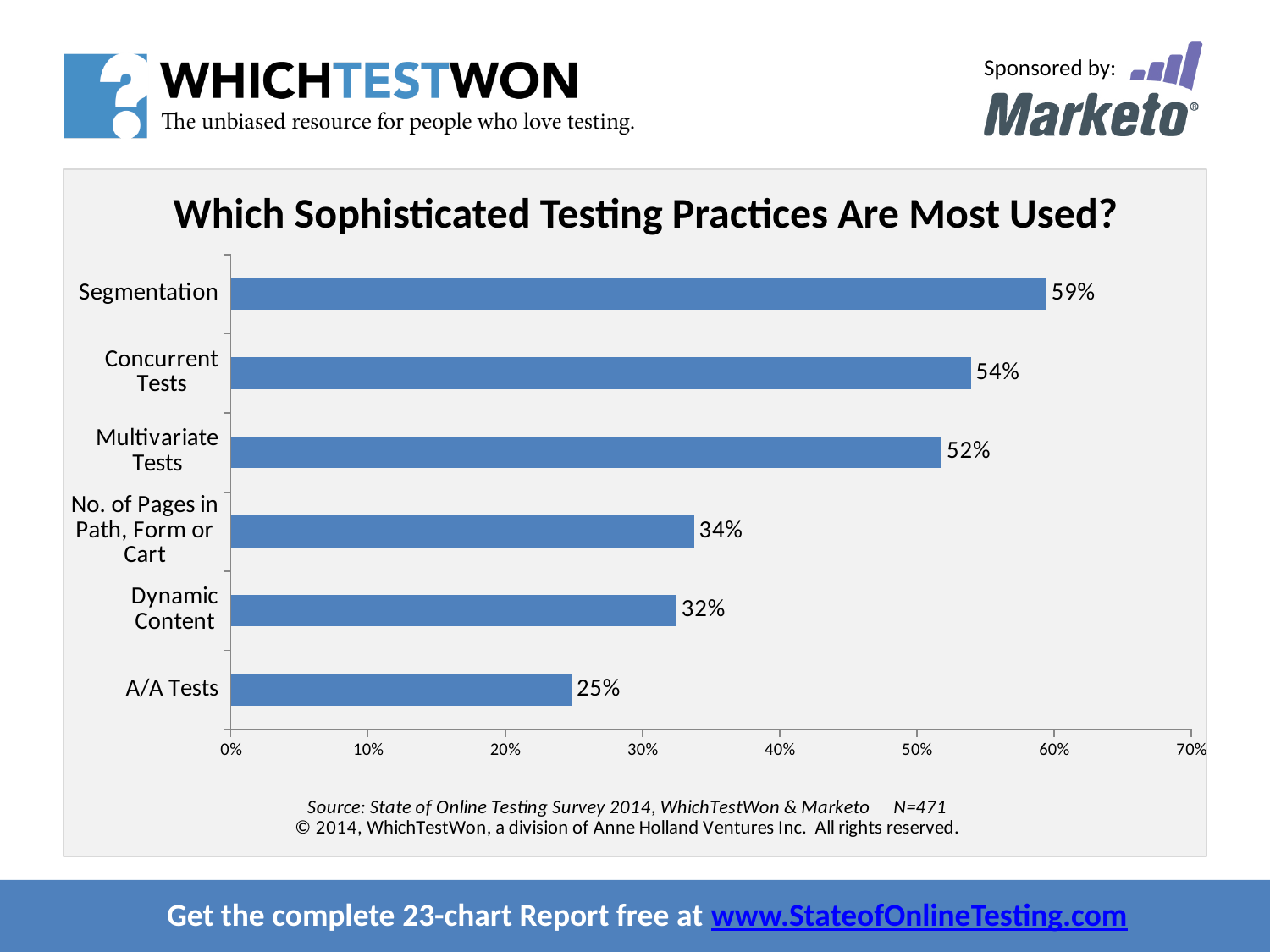
Which testing practice has the highest value? Segmentation What is the difference between Concurrent Tests and Multivariate Tests? 2% What is the difference between the values for Segmentation and A/A Tests? 34% What is the title of the chart? Which Sophisticated Testing Practices Are Most Used? What is the value for Multivariate Tests? 52% Which testing practice has the lowest value? A/A Tests Is the value for Concurrent Tests greater or less than 50%? greater Which is larger, the value for No. of Pages in Path, Form or Cart or the value for Dynamic Content? No. of Pages in Path, Form or Cart What kind of chart is shown on the slide? Bar chart How many testing practices are shown in the chart? 6 What percentage of respondents use Segmentation? 59% What is the value for Dynamic Content? 32%